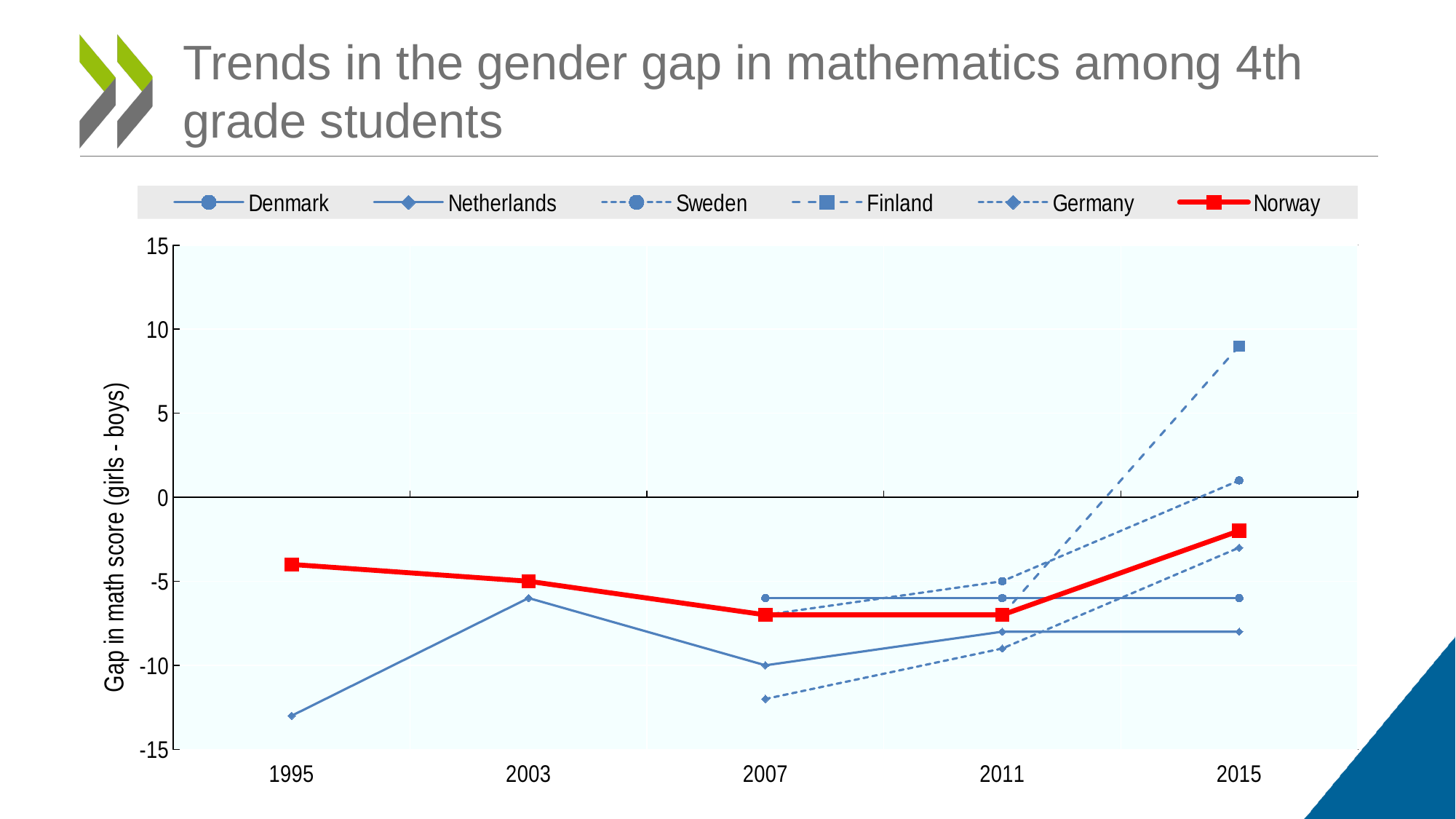
How many series does the legend list? 6 Is the value for Finland in 2015 greater or less than 5? greater Is the value for the Netherlands in 1995 greater or less than -10? less Which country has the lowest value in 2007? Germany In 2015, which is higher: Norway or the Netherlands? Norway What is the value for the Netherlands in 2007? -10 How many years are shown on the x axis? 5 What is the value for Norway in 2003? -5 Is the value for Germany in 2007 greater or less than -10? less What kind of chart is shown on the slide? line chart Which country has the highest value in 2015? Finland Does the Norway line rise or fall between 2011 and 2015? rise